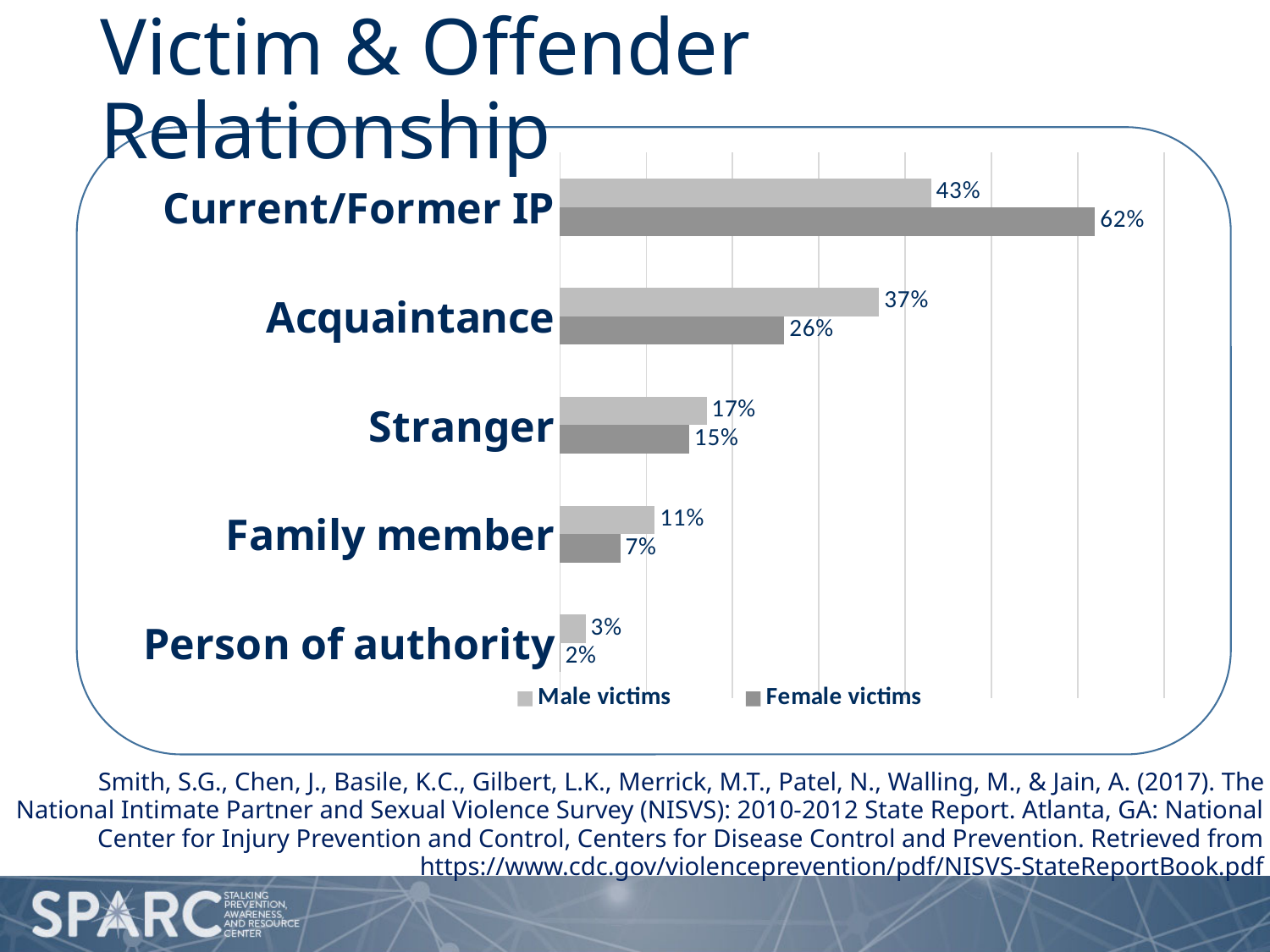
What type of chart is shown on the slide? Bar chart What percentage of female victims were stalked by a current/former IP? 62% How many relationship categories are shown on the chart? 5 What is the value for male victims in the Stranger category? 17% How many series does the legend list? 2 What percentage of male victims were stalked by an acquaintance? 37% Which category has the highest value for female victims? Current/Former IP What is the difference between female victims and male victims for Current/Former IP? 19% What is the value for female victims in the Family member category? 7% Which category has the lowest value for male victims? Person of authority Which is larger for the Acquaintance category: male victims or female victims? Male victims What are the two series named in the legend? Male victims and Female victims